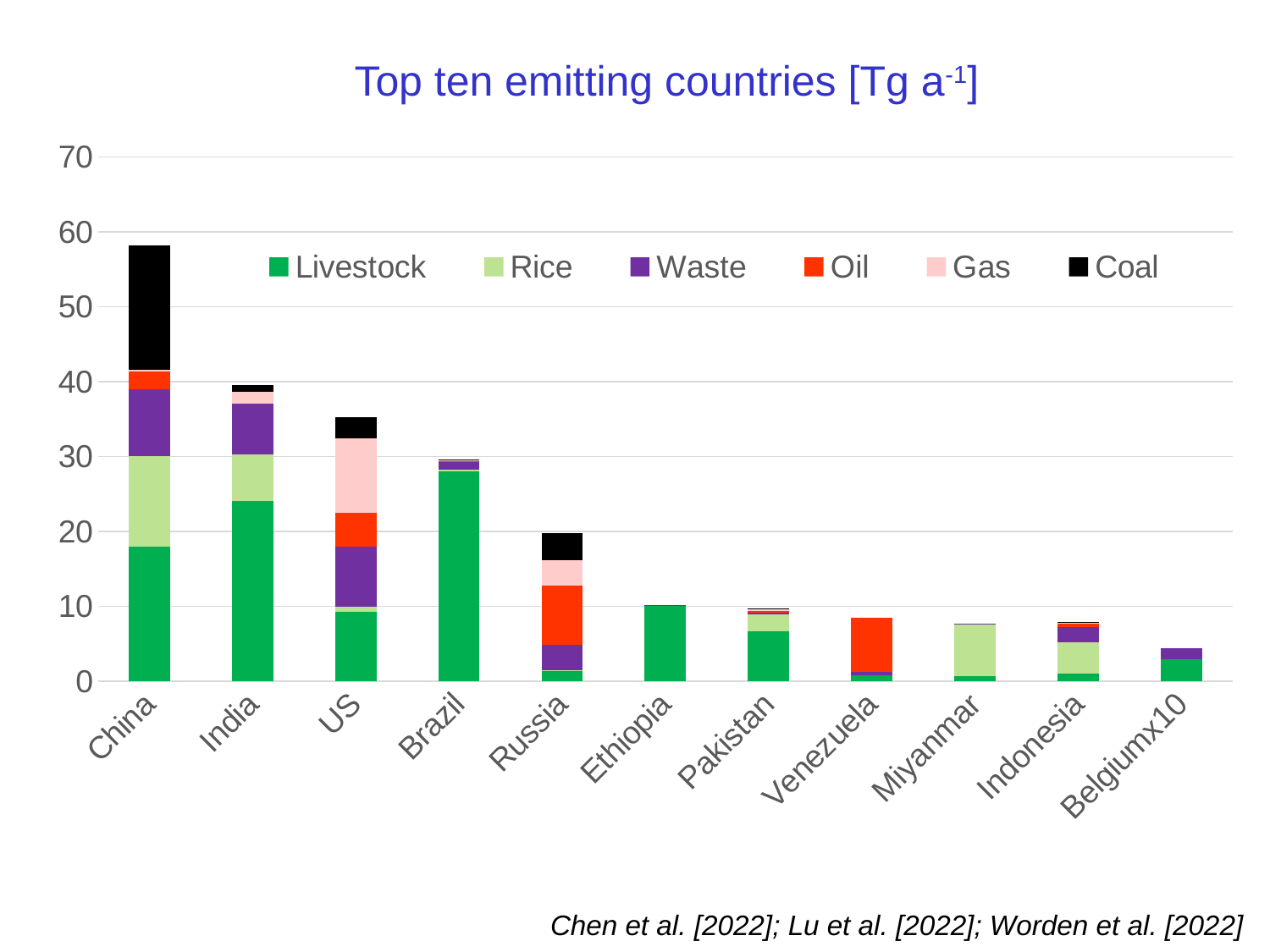
Is the total value for China greater or less than 50? greater Is the total value for Miyanmar greater or less than 10? less Which has a larger total bar, China or India? China What kind of chart is shown on the slide? Stacked bar chart Is the total value for US greater or less than 30? greater Which country has the highest total emissions bar? China What is the title of the chart? Top ten emitting countries [Tg a-1] How many series does the legend list? 6 Which country has the lowest total emissions bar? Belgiumx10 Which country has the largest Coal segment? China How many countries (bars) are shown on the x axis? 11 Do the total bar heights generally rise or fall from left to right along the x axis? Fall